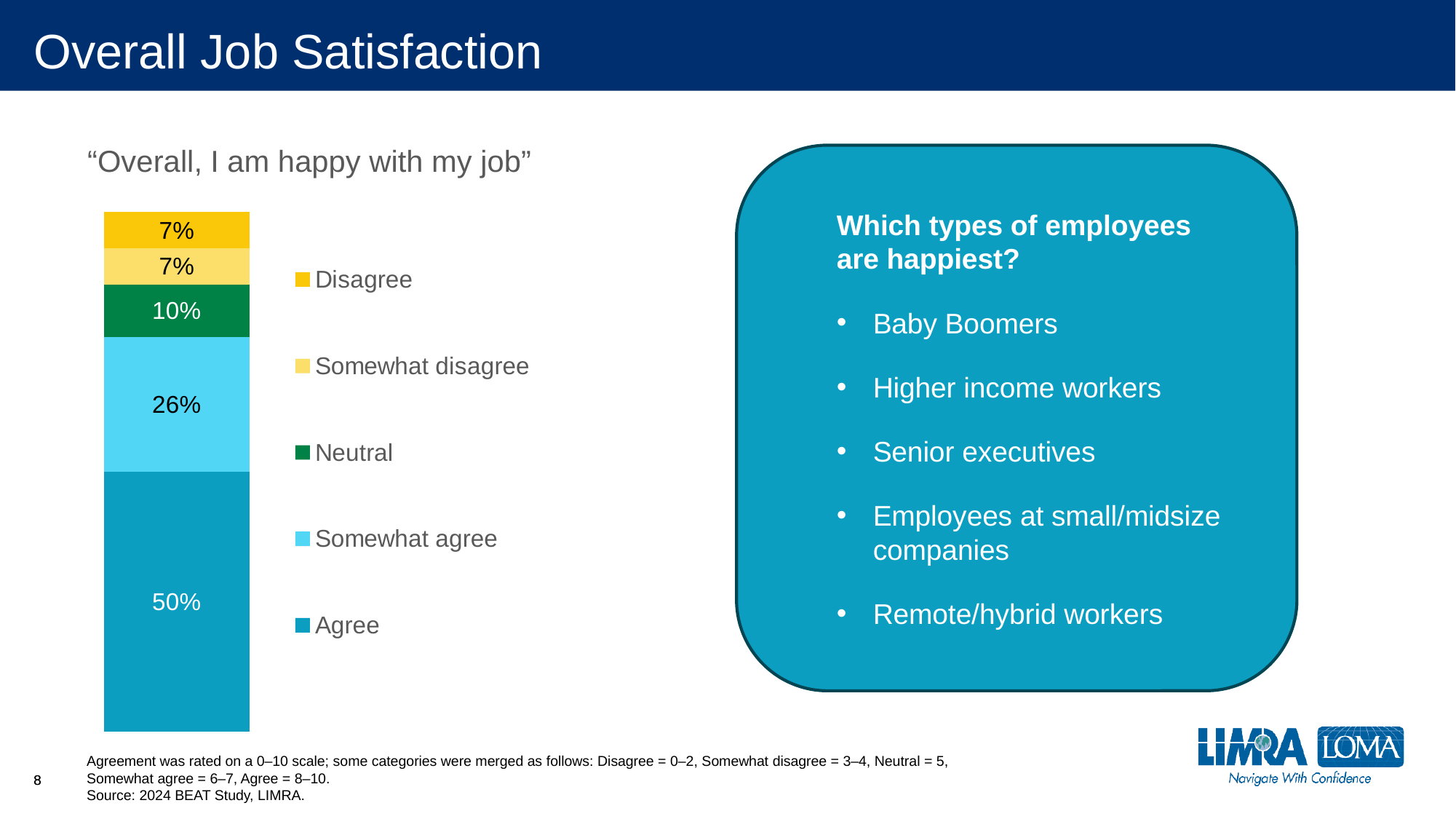
What type of chart is shown on the slide? Stacked bar chart Which legend entry is shown in dark green? Neutral What is the difference between the Agree and Somewhat agree percentages? 24 percentage points Which is larger, the Neutral share or the Somewhat disagree share? Neutral What percentage of respondents are neutral about being happy with their job? 10% What percentage of respondents disagree that they are happy with their job? 7% How many response categories does the legend list? 5 What percentage of respondents somewhat agree that they are happy with their job? 26% What percentage of respondents agree with the statement "Overall, I am happy with my job"? 50% Which response category has the largest share in the stacked bar? Agree What is the combined percentage of respondents who disagree or somewhat disagree? 14% What is the combined percentage of respondents who agree or somewhat agree? 76%